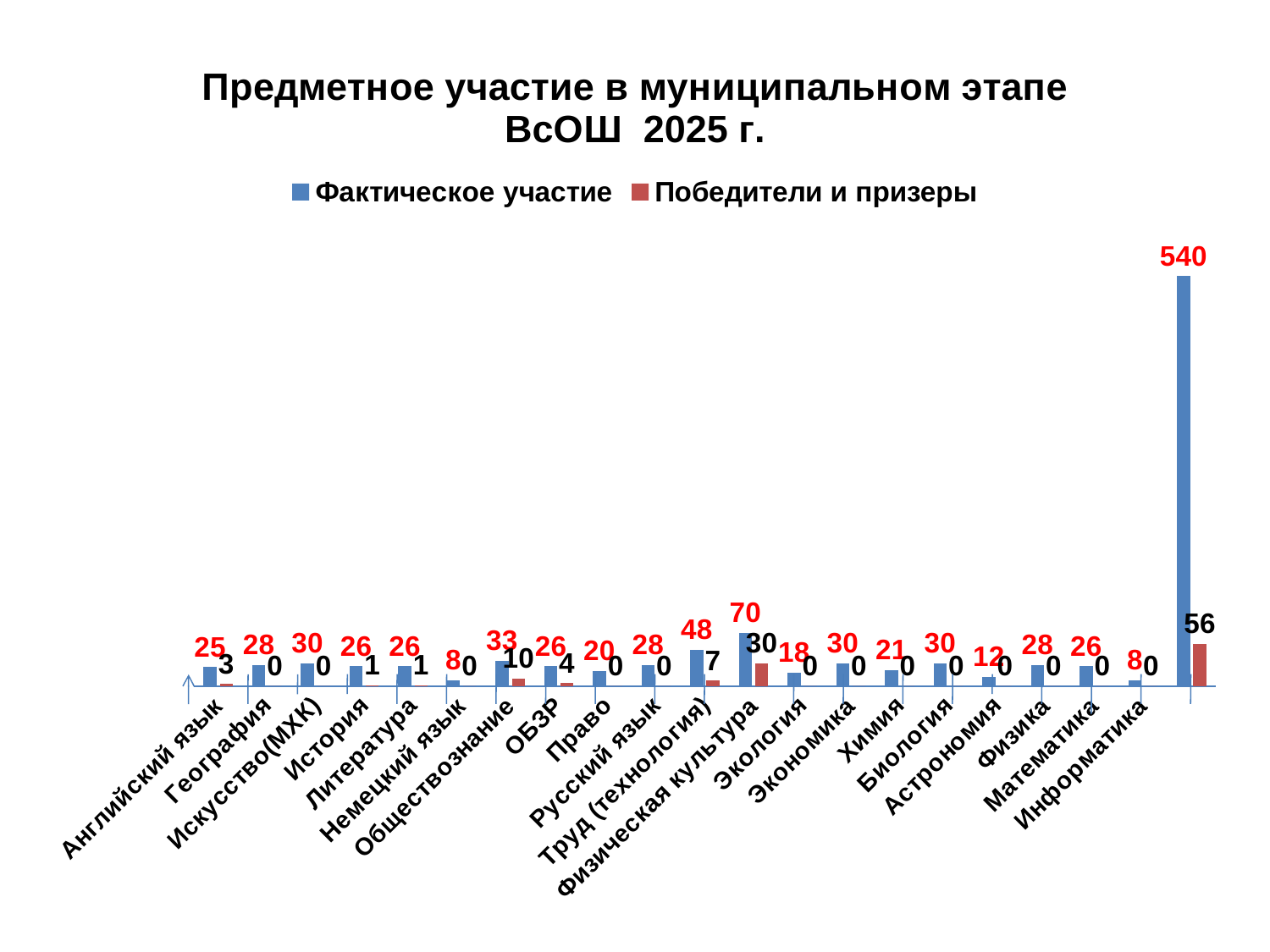
What is the value of Фактическое участие for Астрономия? 12 What is the highest value shown for the Фактическое участие series? 540 What is the value of Победители и призеры for ОБЗР? 4 What is the value of Фактическое участие for Труд (технология)? 48 How many series does the legend list? 2 What is the title of the chart? Предметное участие в муниципальном этапе ВсОШ 2025 г. What is the value of Победители и призеры for Обществознание? 10 What kind of chart is shown on the slide? Bar chart What is the difference between the Победители и призеры values for Физическая культура and Труд (технология)? 23 What is the difference between Фактическое участие and Победители и призеры for Физическая культура? 40 What is the value of Фактическое участие for Физическая культура? 70 Which has a higher Фактическое участие value, Труд (технология) or Обществознание? Труд (технология)